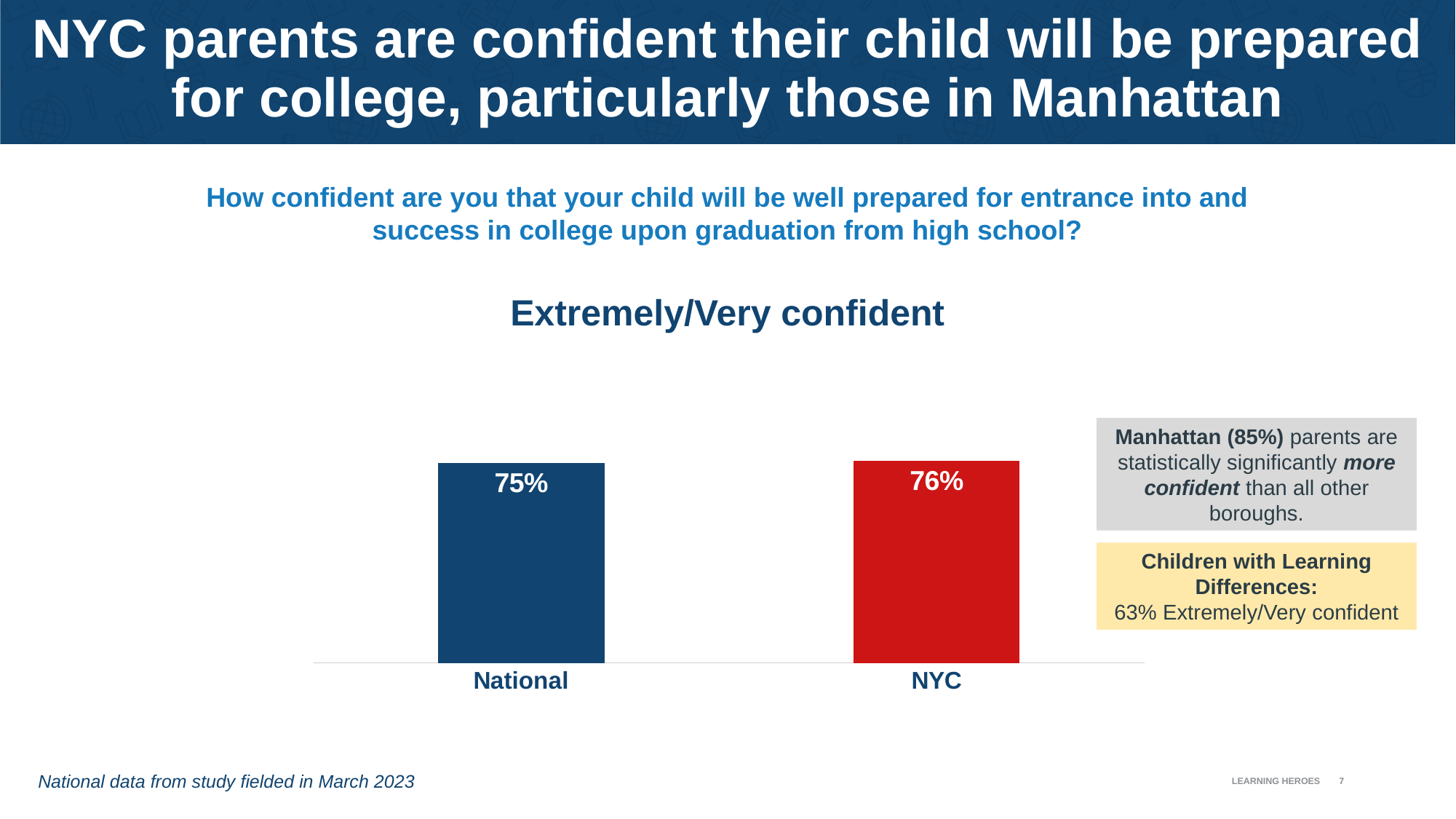
Which category has the lowest value in the chart? National What is the difference between the NYC value and the National value? 1 percentage point Which category has the highest value in the chart? NYC How many categories are shown in the chart? 2 What is the value for NYC in the Extremely/Very confident chart? 76% What is the value for National in the Extremely/Very confident chart? 75% What kind of chart is shown on the slide? Bar chart What colour is the NYC bar? Red What is the title of the chart? Extremely/Very confident Which category has the higher value, National or NYC? NYC